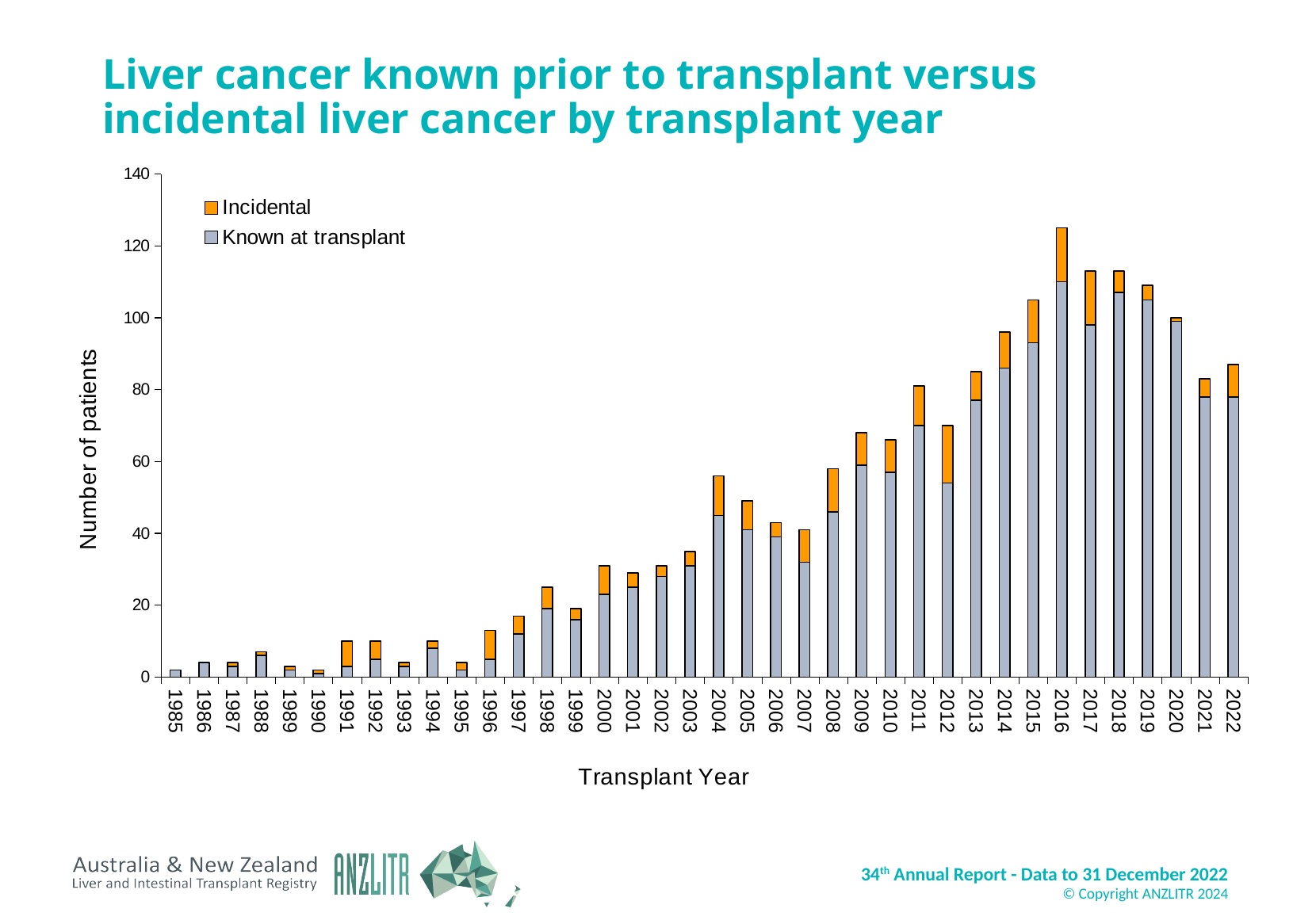
How many transplant years are shown on the x axis? 38 Which transplant year has the highest total number of patients? 2016 Is the total number of patients for 2015 greater or less than 100? greater Is the total number of patients for 2004 greater or less than 40? greater Is the total number of patients for 1998 greater or less than 20? greater What kind of chart is shown on the slide? Stacked bar chart Does the total number of patients generally rise or fall from 1985 to 2016? Rise Which colour represents the Incidental series in the legend? Orange Which year has a higher total number of patients, 2013 or 2014? 2014 How many series does the legend list? 2 Which year has a higher total number of patients, 2016 or 2017? 2016